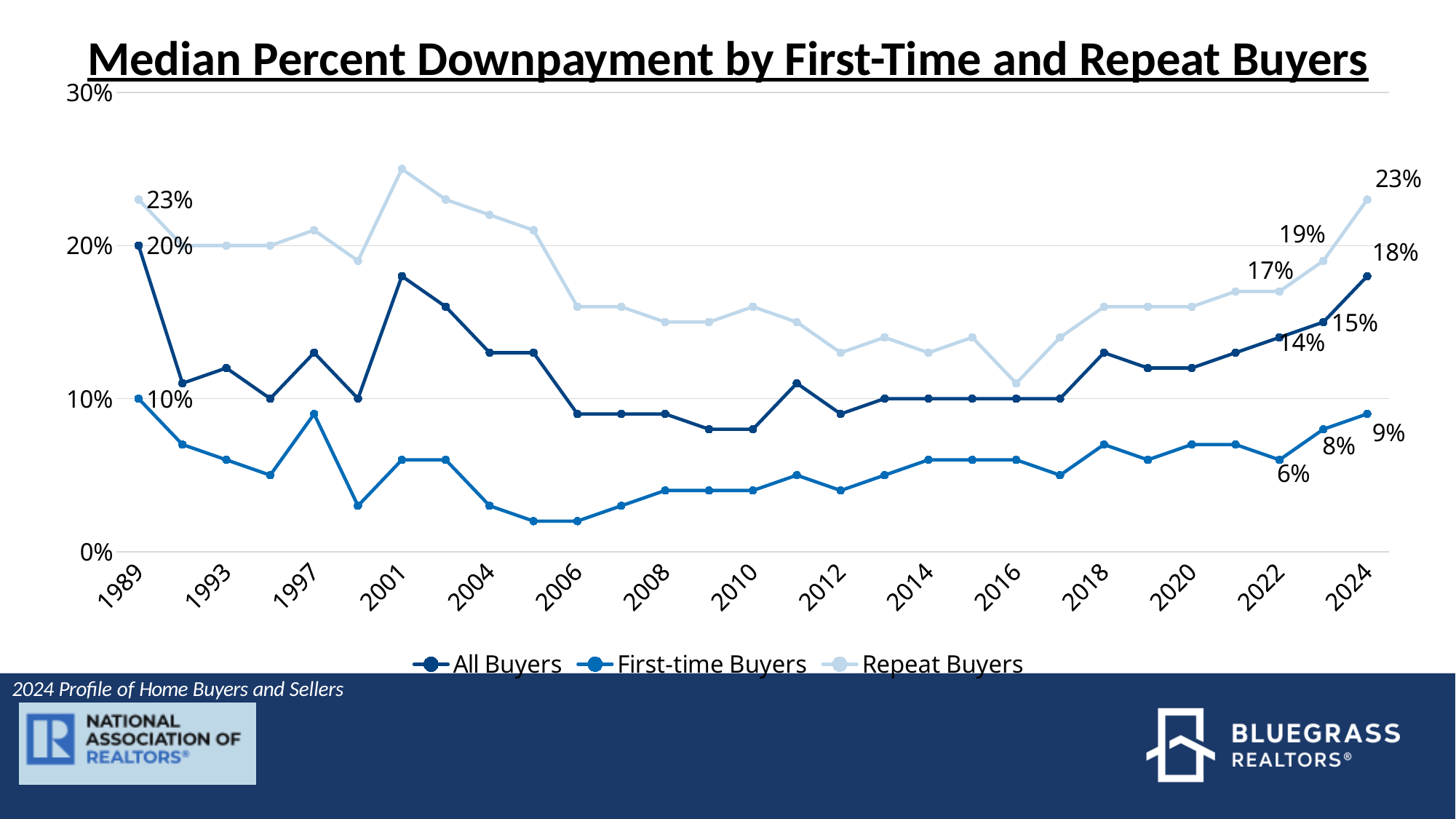
What was the median percent downpayment for First-time Buyers in 1989? 10% What was the median percent downpayment for All Buyers in 2024? 18% Which year had the higher median percent downpayment for All Buyers, 1989 or 2024? 1989 Is the value for Repeat Buyers in 2001 greater or less than 20%? greater What was the median percent downpayment for Repeat Buyers in 1989? 23% Which series has the highest value in 2024? Repeat Buyers Is the value for First-time Buyers in 2006 greater or less than 10%? less What kind of chart is shown on the slide? Line chart In 2024, how many percentage points higher is the Repeat Buyers value than the First-time Buyers value? 14 percentage points What was the median percent downpayment for Repeat Buyers in 2022? 17% How many series does the legend list? 3 What was the median percent downpayment for First-time Buyers in 2024? 9%